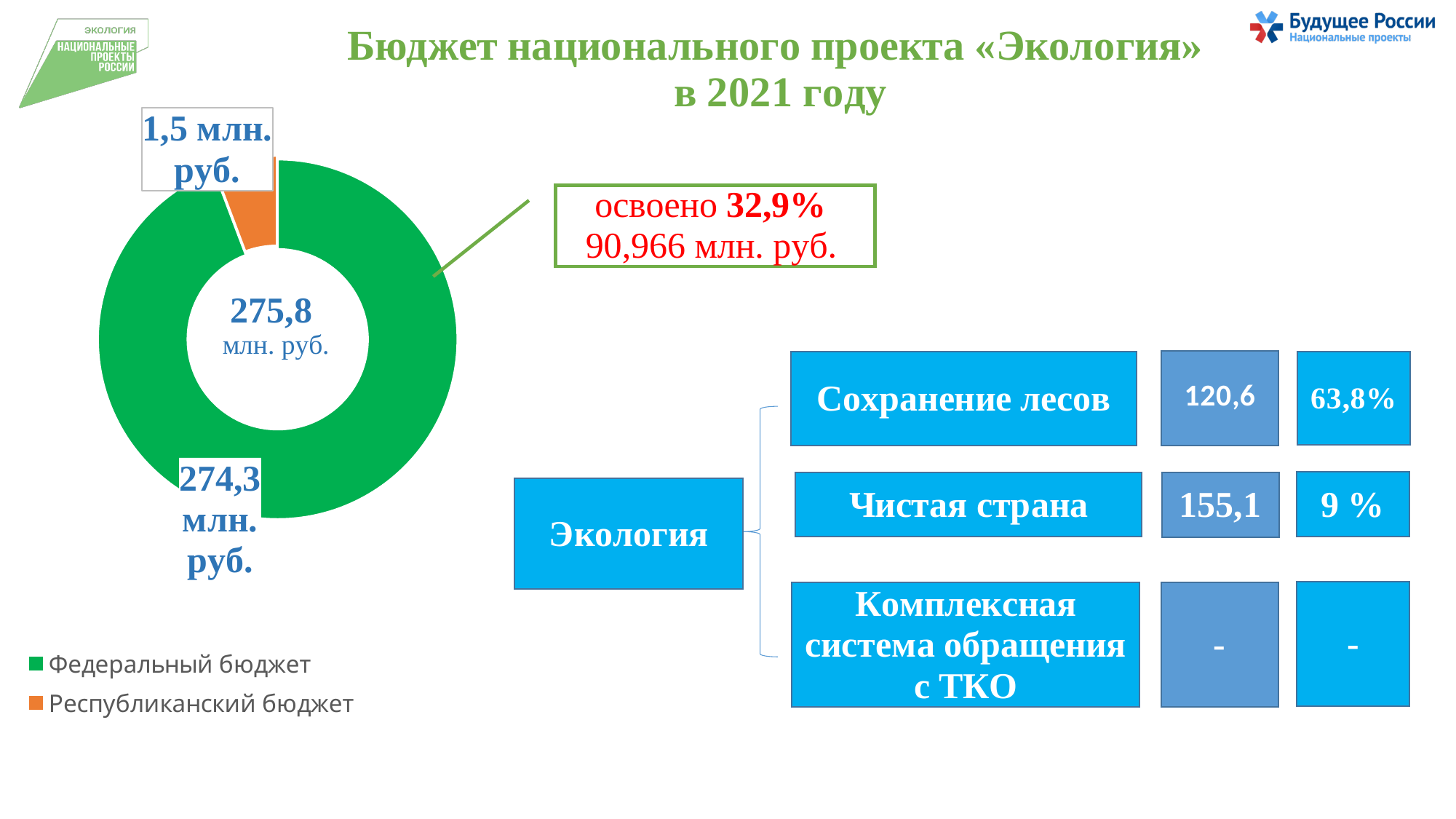
Which slice of the doughnut chart is the largest? Федеральный бюджет Which slice of the doughnut chart is the smallest? Республиканский бюджет What is the difference between the Федеральный бюджет and Республиканский бюджет values in the doughnut chart? 272,8 млн. руб. How many slices does the doughnut chart have? 2 What colour is the Федеральный бюджет slice in the doughnut chart? Green What total value is shown in the centre of the doughnut chart? 275,8 млн. руб. Which is larger in the doughnut chart, Федеральный бюджет or Республиканский бюджет? Федеральный бюджет What kind of chart is shown on the slide? Doughnut chart What is the value for Республиканский бюджет in the doughnut chart? 1,5 млн. руб. What colour is the Республиканский бюджет slice in the doughnut chart? Orange How many entries does the legend of the doughnut chart list? 2 What is the value for Федеральный бюджет in the doughnut chart? 274,3 млн. руб.